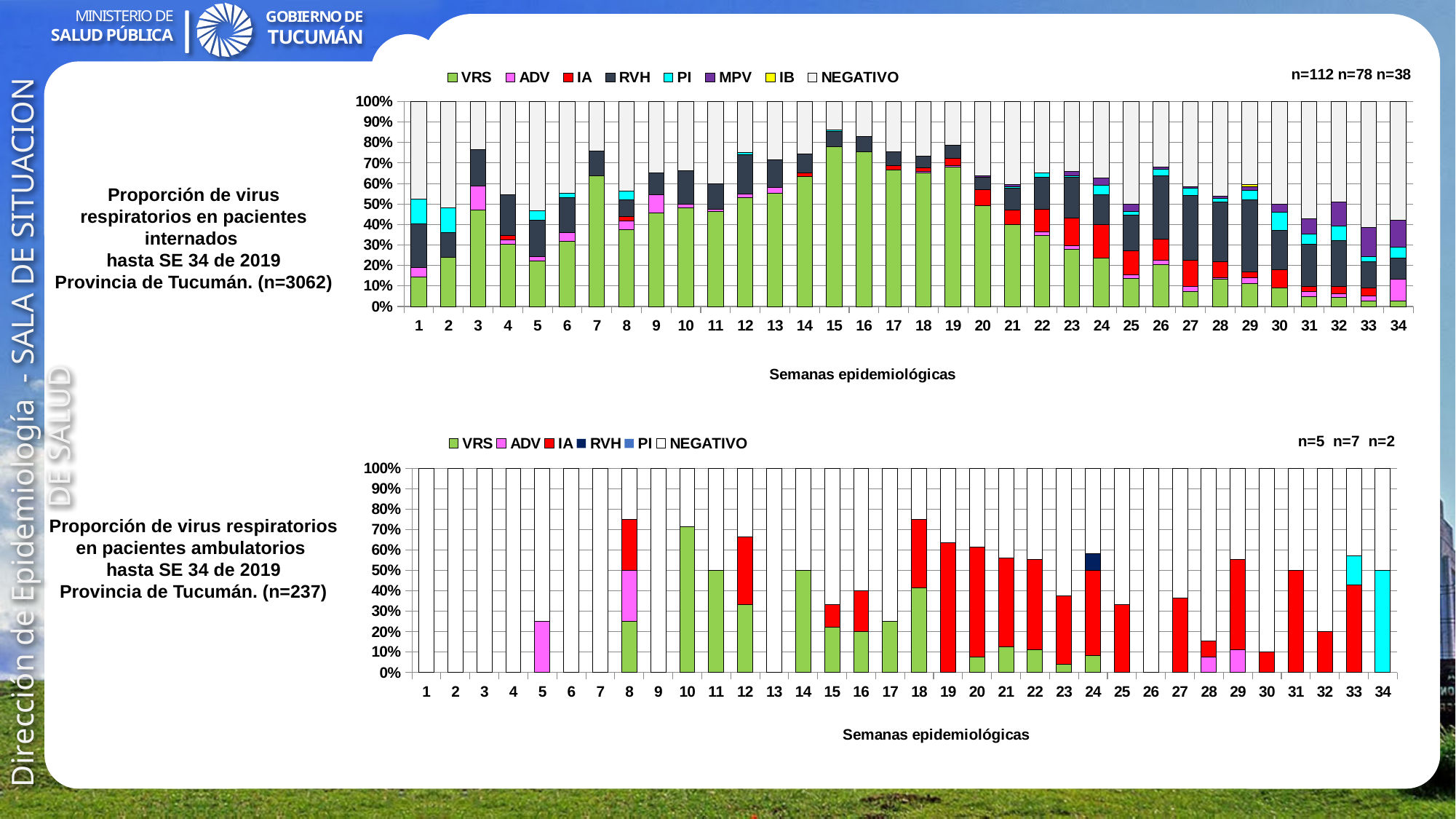
How many series does the legend of the top chart (pacientes internados) list? 8 What kind of chart is the top chart (pacientes internados)? Stacked bar chart In the top chart (pacientes internados), which has the larger VRS share, week 1 or week 7? Week 7 In the bottom chart (pacientes ambulatorios), is the VRS share in week 10 greater or less than 50%? greater What is the x-axis title of the top chart (pacientes internados)? Semanas epidemiológicas In the top chart (pacientes internados), is the VRS share in week 34 greater or less than 10%? less In the bottom chart (pacientes ambulatorios), which week has the largest IA share? Week 19 In the bottom chart (pacientes ambulatorios), is the ADV share in week 5 greater or less than 50%? less How many epidemiological weeks are shown on the x axis of the bottom chart (pacientes ambulatorios)? 34 How many series does the legend of the bottom chart (pacientes ambulatorios) list? 6 In the bottom chart (pacientes ambulatorios), which week has the largest VRS share? Week 10